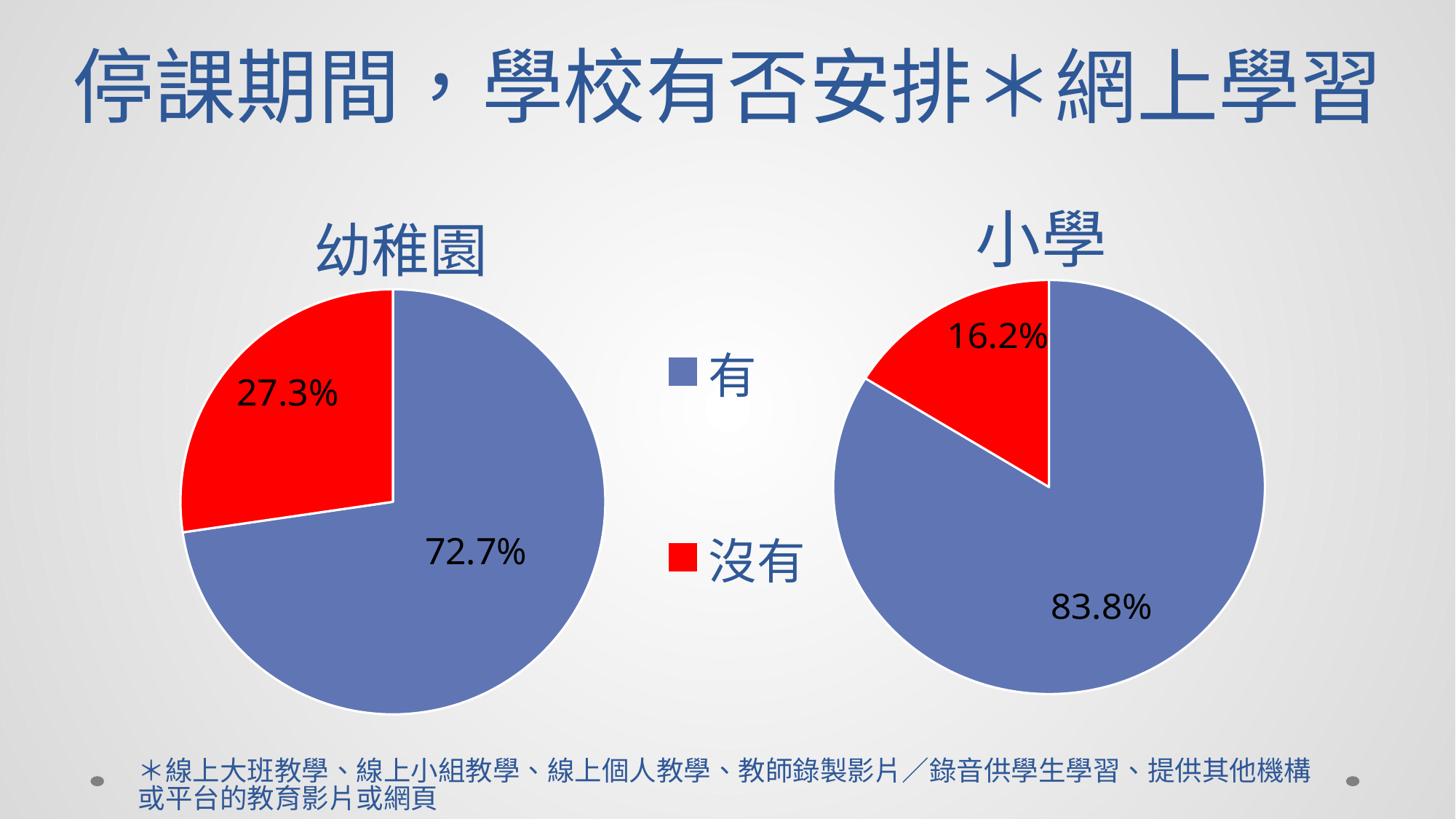
How many slices does the 小學 pie chart have? 2 In the 幼稚園 pie chart, which category has the largest slice? 有 What colour represents 沒有 in the legend? Red In the 小學 pie chart, what percentage is shown for 沒有? 16.2% In the 幼稚園 pie chart, what is the difference between the 有 and 沒有 percentages? 45.4% In the 幼稚園 pie chart, what percentage is shown for 沒有? 27.3% In the 小學 pie chart, which category has the smallest slice? 沒有 Comparing the two pie charts, which has the larger 沒有 share, 幼稚園 or 小學? 幼稚園 What type of chart is used on the left for 幼稚園? Pie chart How many entries does the legend list? 2 In the 小學 pie chart, what percentage is shown for 有? 83.8% In the 幼稚園 pie chart, what percentage is shown for 有? 72.7%